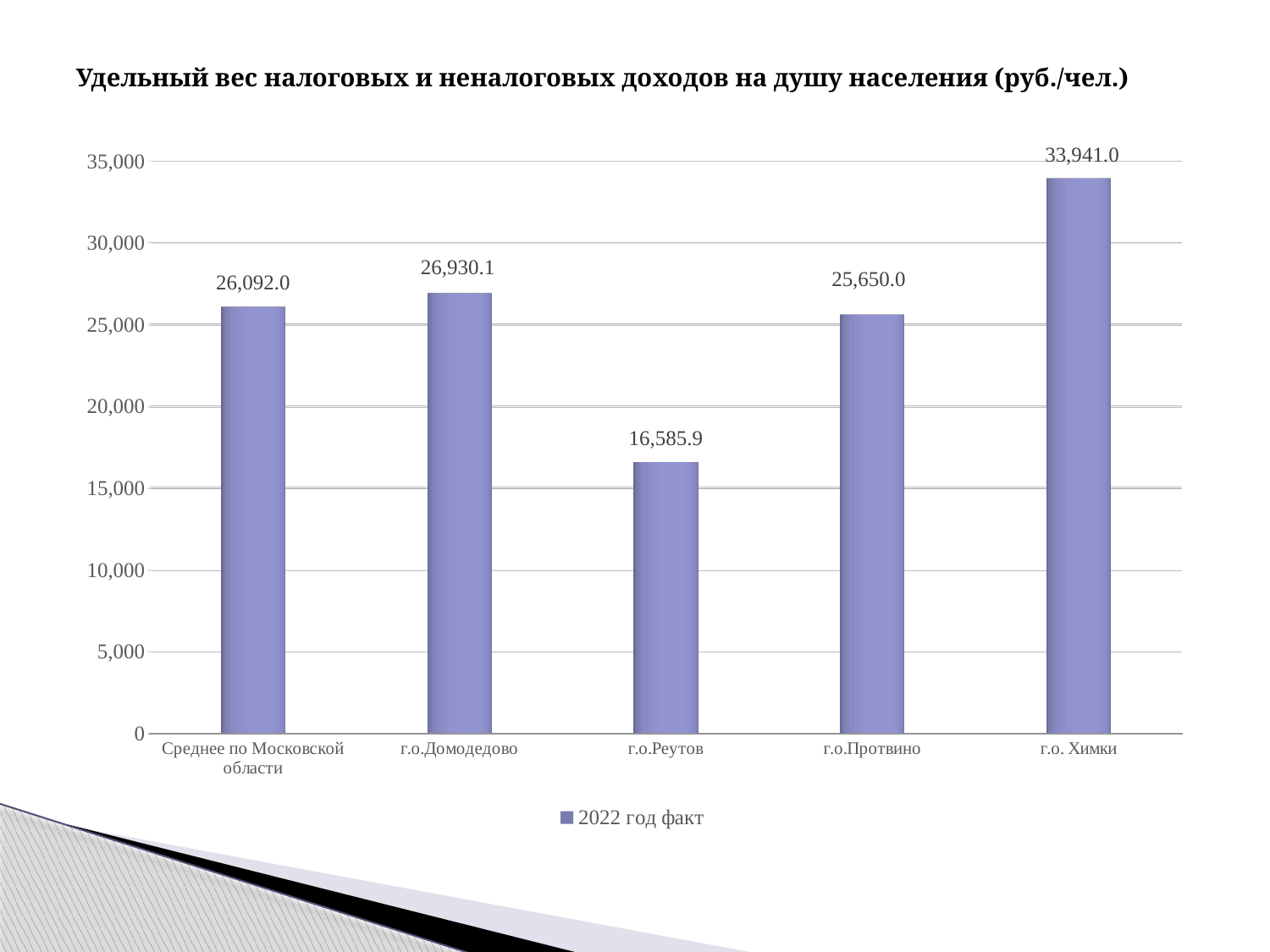
What is the value for г.о.Домодедово? 26,930.1 What is the difference between the values for г.о. Химки and г.о.Реутов? 17,355.1 Is the value for г.о.Протвино greater or less than 25,000? greater What is the value for г.о.Реутов? 16,585.9 Which category has the lowest value? г.о.Реутов What is the value for Среднее по Московской области? 26,092.0 Which is larger, the value for г.о.Домодедово or the value for г.о.Протвино? г.о.Домодедово Which category has the highest value? г.о. Химки How many series does the legend list? 1 What kind of chart is shown on the slide? bar chart What is the value for г.о. Химки? 33,941.0 How many categories are shown on the x axis? 5